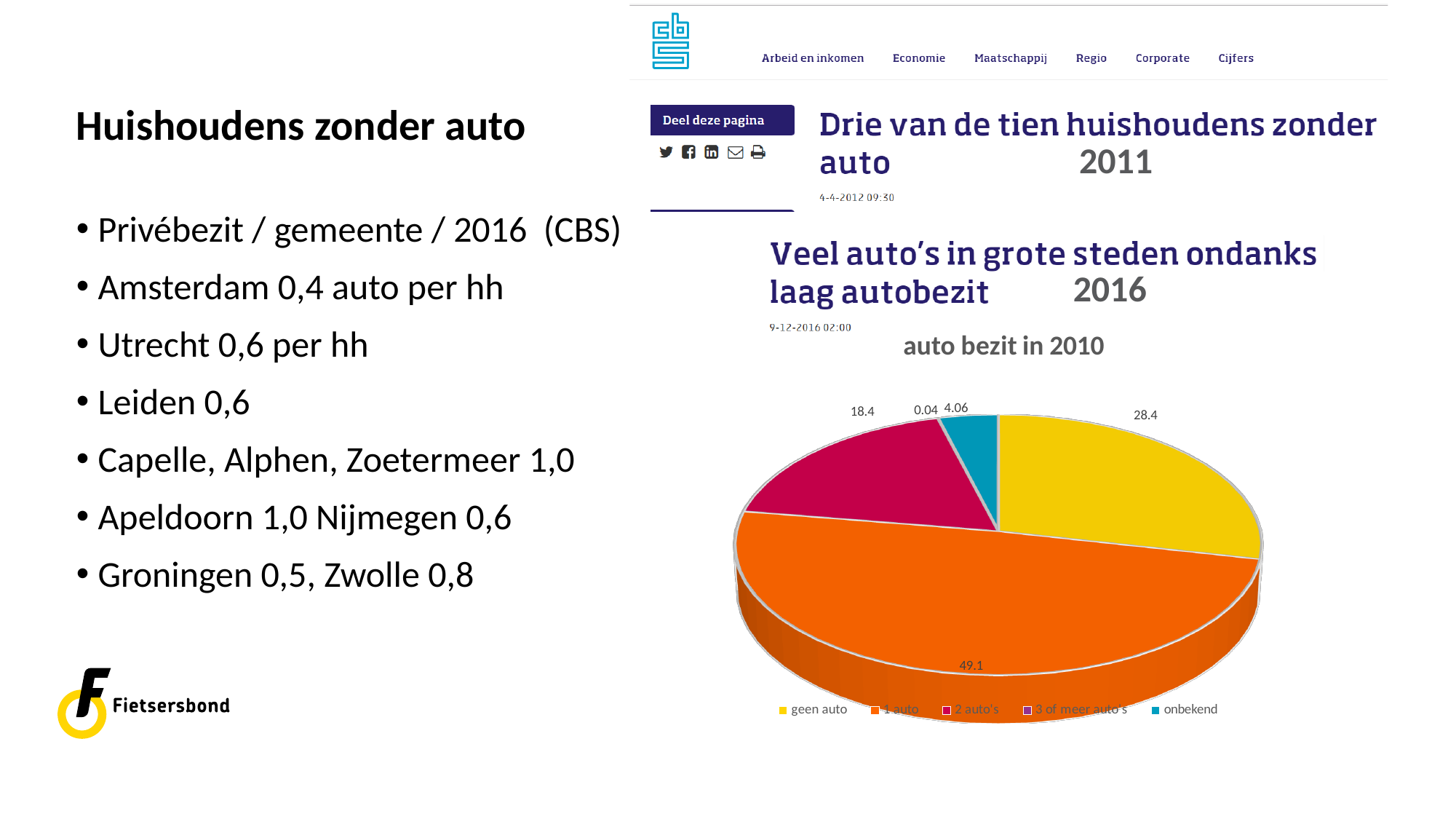
How many categories does the legend of the pie chart list? 5 What is the value for the '1 auto' slice in the pie chart? 49.1 What is the title of the pie chart? auto bezit in 2010 What is the value for the '3 of meer auto's' slice in the pie chart? 0.04 What is the value for the '2 auto's' slice in the pie chart? 18.4 Which category has the largest slice in the pie chart? 1 auto What type of chart is shown on the slide? pie chart What is the value for the 'onbekend' slice in the pie chart? 4.06 Which category has the smallest slice in the pie chart? 3 of meer auto's Which is larger in the pie chart, 'geen auto' or '2 auto's'? geen auto What is the difference between the '1 auto' and 'geen auto' values in the pie chart? 20.7 What is the value for the 'geen auto' slice in the pie chart? 28.4